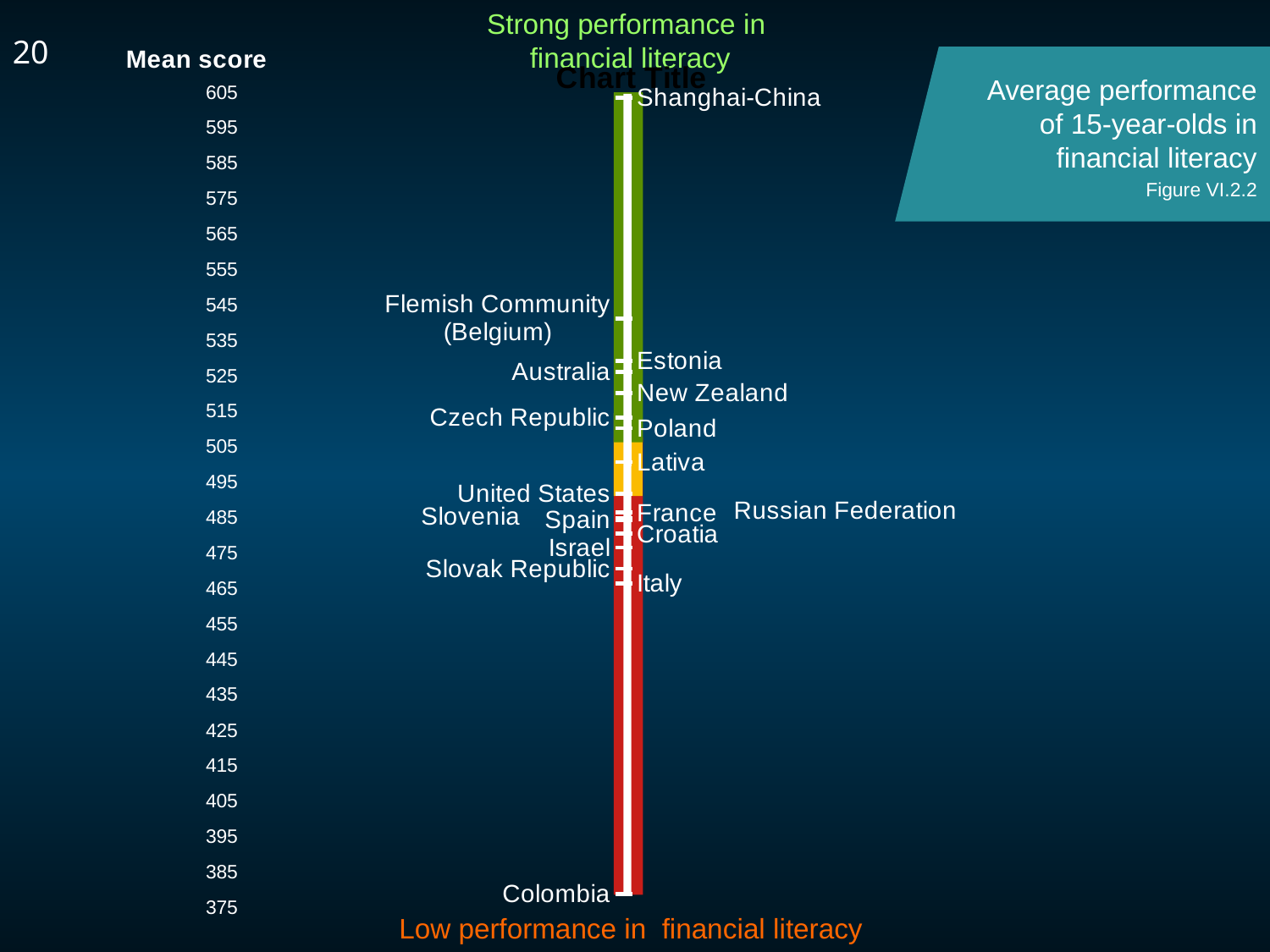
Is the mean score for Shanghai-China greater or less than 595? greater What is the label of the vertical axis? Mean score Which country has the lowest mean score on the chart? Colombia Is the mean score for Italy greater or less than 475? less Is the mean score for the Flemish Community (Belgium) greater or less than 535? greater Which has the higher mean score, the Flemish Community (Belgium) or Australia? Flemish Community (Belgium) How many countries or economies are labelled on the chart? 18 Which country or economy has the highest mean score on the chart? Shanghai-China Which has the higher mean score, Poland or the Slovak Republic? Poland